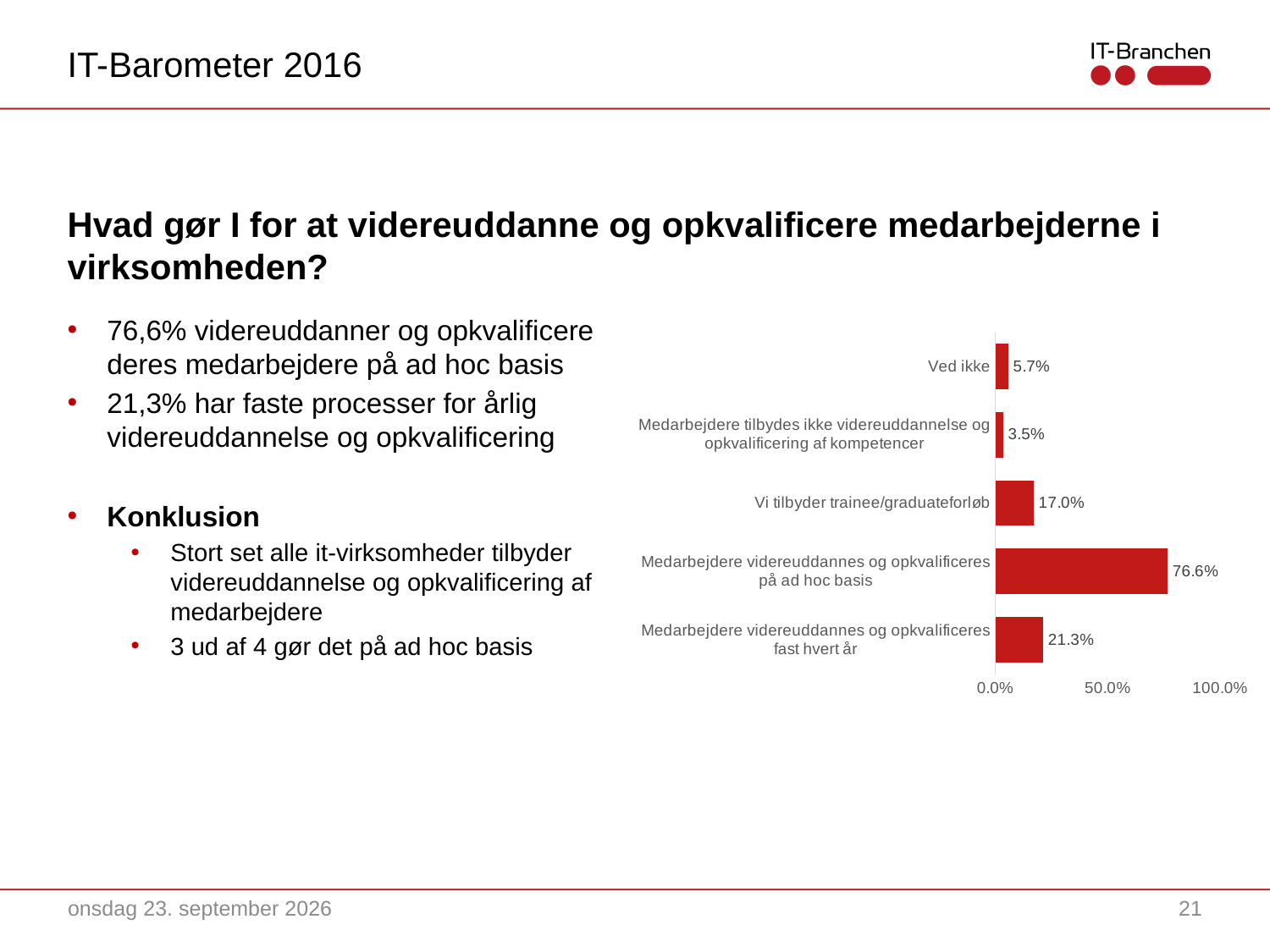
What is the value for "Medarbejdere tilbydes ikke videreuddannelse og opkvalificering af kompetencer"? 3.5% What is the maximum value shown on the x axis of the chart? 100.0% What kind of chart is shown on the slide? bar chart What is the value for "Medarbejdere videreuddannes og opkvalificeres fast hvert år"? 21.3% Which category has the lowest value? Medarbejdere tilbydes ikke videreuddannelse og opkvalificering af kompetencer Which category has the highest value? Medarbejdere videreuddannes og opkvalificeres på ad hoc basis What is the value for "Ved ikke"? 5.7% What is the difference between the values for "Medarbejdere videreuddannes og opkvalificeres på ad hoc basis" and "Medarbejdere videreuddannes og opkvalificeres fast hvert år"? 55.3% What is the value for "Vi tilbyder trainee/graduateforløb"? 17.0% Which is larger: the value for "Vi tilbyder trainee/graduateforløb" or the value for "Ved ikke"? Vi tilbyder trainee/graduateforløb How many categories are shown in the chart? 5 Is the value for "Medarbejdere videreuddannes og opkvalificeres på ad hoc basis" greater or less than 50.0%? greater